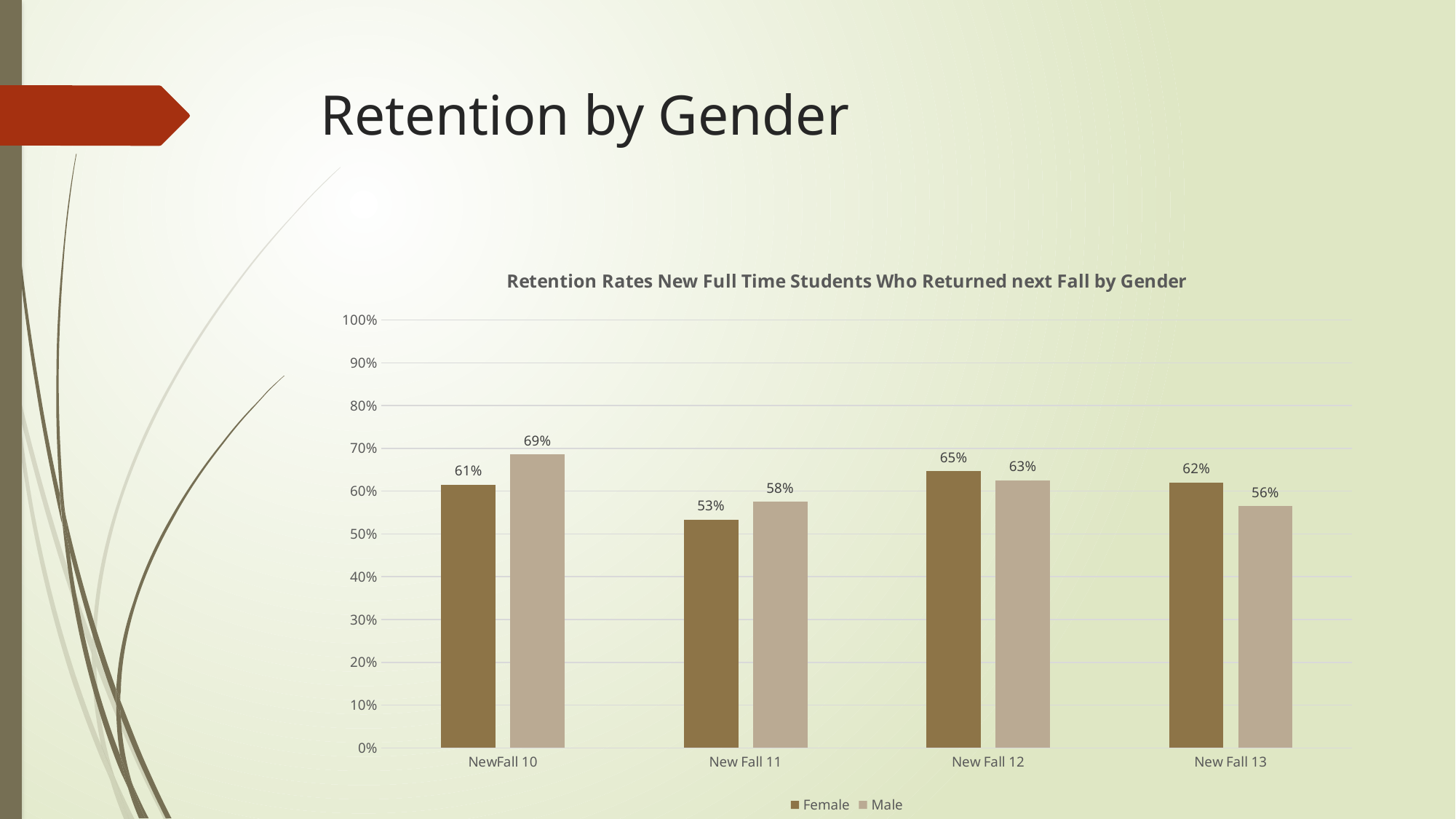
What is the Female retention rate for NewFall 10? 61% How many series does the legend list? 2 For New Fall 13, which is larger, the Female or the Male retention rate? Female What is the Male retention rate for New Fall 11? 58% Which cohort has the lowest Female retention rate? New Fall 11 What is the title of the chart? Retention Rates New Full Time Students Who Returned next Fall by Gender Does the Male retention rate rise or fall from New Fall 12 to New Fall 13? Fall What is the Male retention rate for New Fall 13? 56% What kind of chart is shown on the slide? Bar chart Which cohort has the highest Male retention rate? NewFall 10 How many cohorts are shown on the x axis? 4 What is the difference between the Male and Female retention rates for NewFall 10? 8%